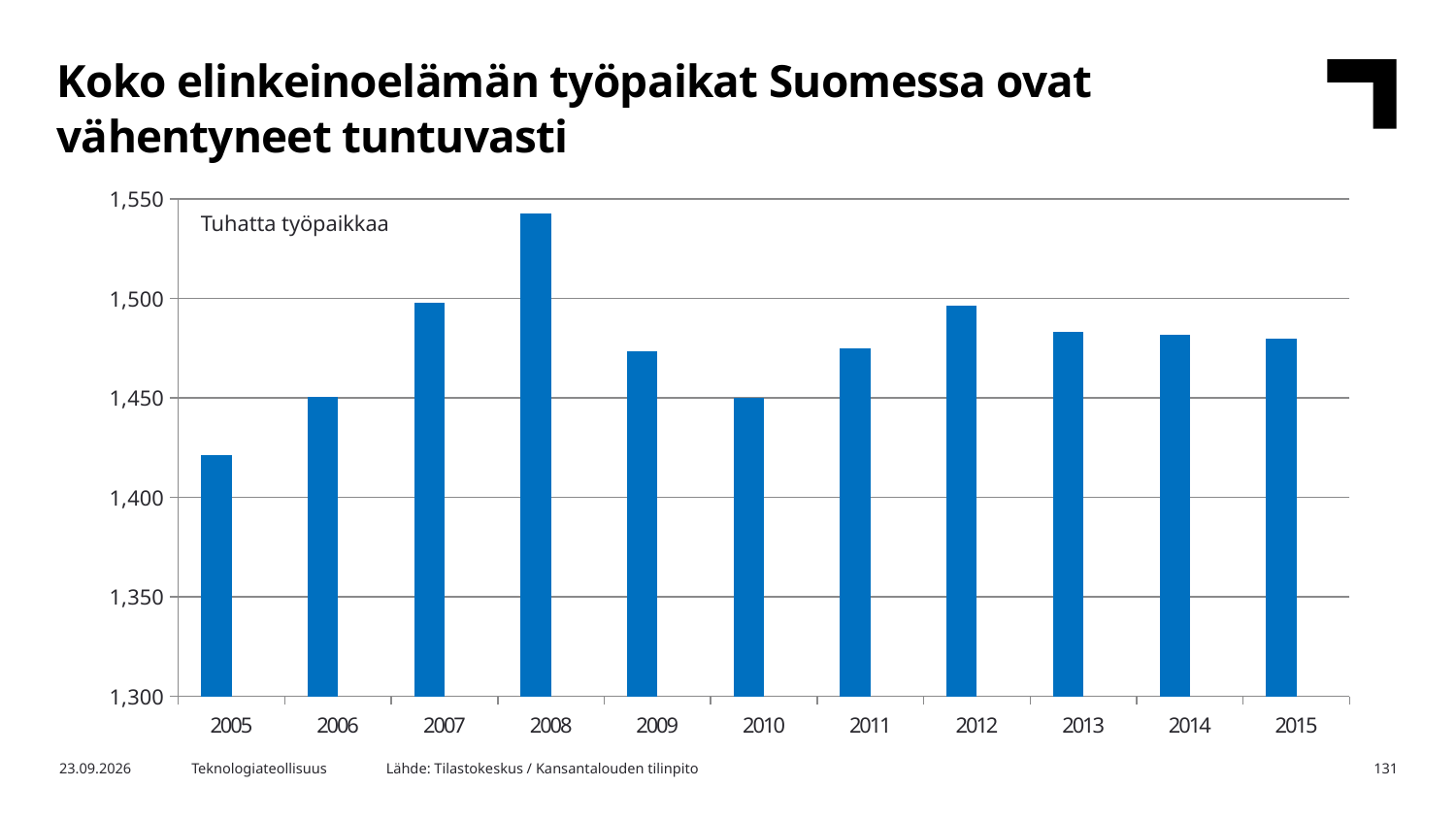
Is the value for 2005 greater or less than 1,450? less Which is larger, the value for 2007 or the value for 2009? 2007 Which is larger, the value for 2012 or the value for 2010? 2012 Is the value for 2009 greater or less than 1,450? greater How many years are shown on the x axis of the chart? 11 Which year has the lowest number of jobs in the chart? 2005 Is the value for 2013 greater or less than 1,500? less Do the values rise or fall from 2012 to 2015? fall What unit label is shown inside the chart area? Tuhatta työpaikkaa Which year has the highest number of jobs in the chart? 2008 What kind of chart is shown on the slide? bar chart